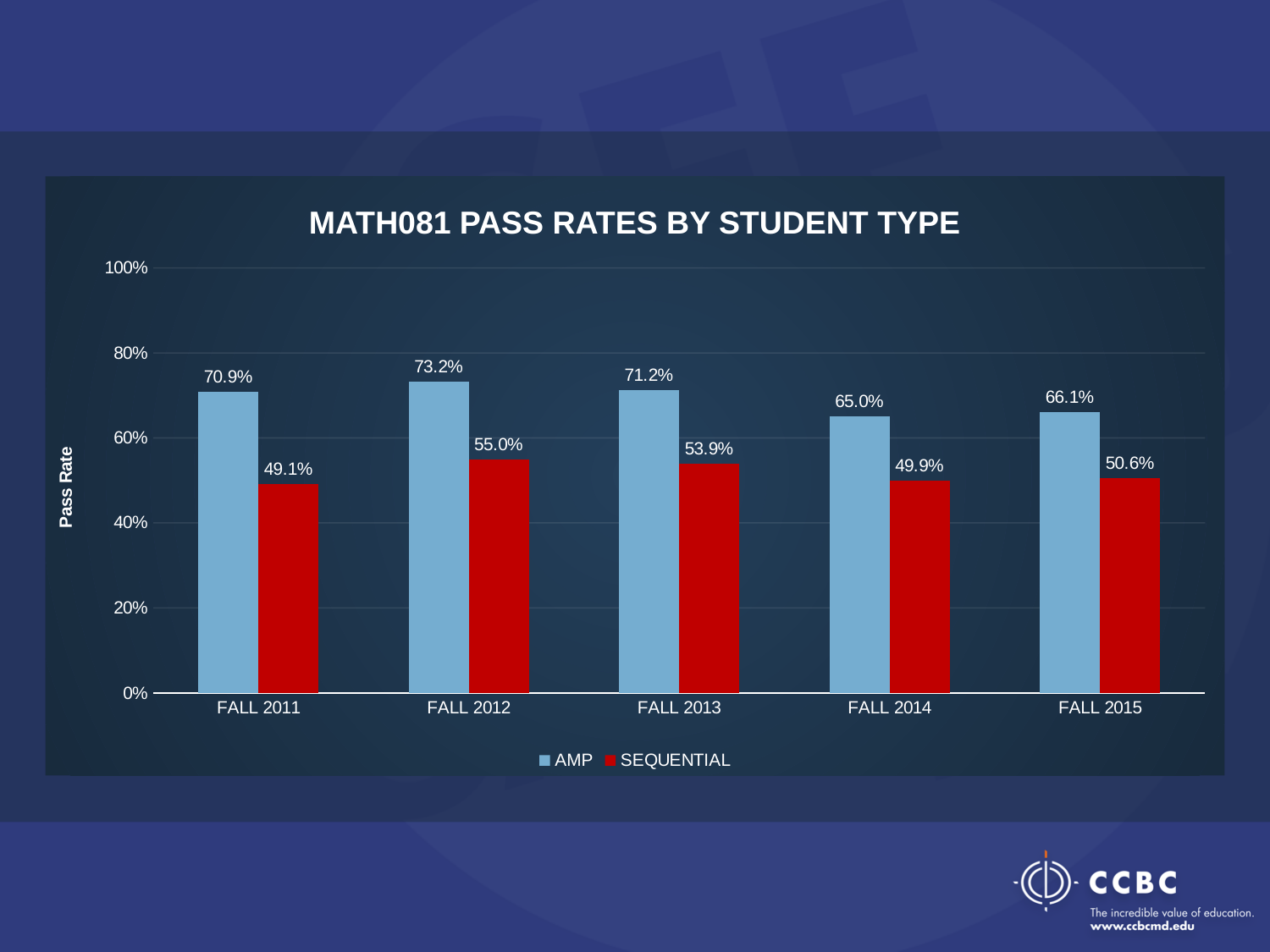
What is the difference between the AMP and SEQUENTIAL pass rates in FALL 2011? 21.8% How many terms are shown on the x axis? 5 What is the SEQUENTIAL pass rate for FALL 2014? 49.9% How many series does the legend list? 2 In which term is the AMP pass rate highest? FALL 2012 Which is larger in FALL 2015, the AMP pass rate or the SEQUENTIAL pass rate? AMP What is the AMP pass rate for FALL 2012? 73.2% What is the label on the vertical axis? Pass Rate What kind of chart is shown on the slide? bar chart In which term is the SEQUENTIAL pass rate lowest? FALL 2011 Is the AMP pass rate for FALL 2014 greater or less than 60%? greater What is the title of the chart? MATH081 PASS RATES BY STUDENT TYPE